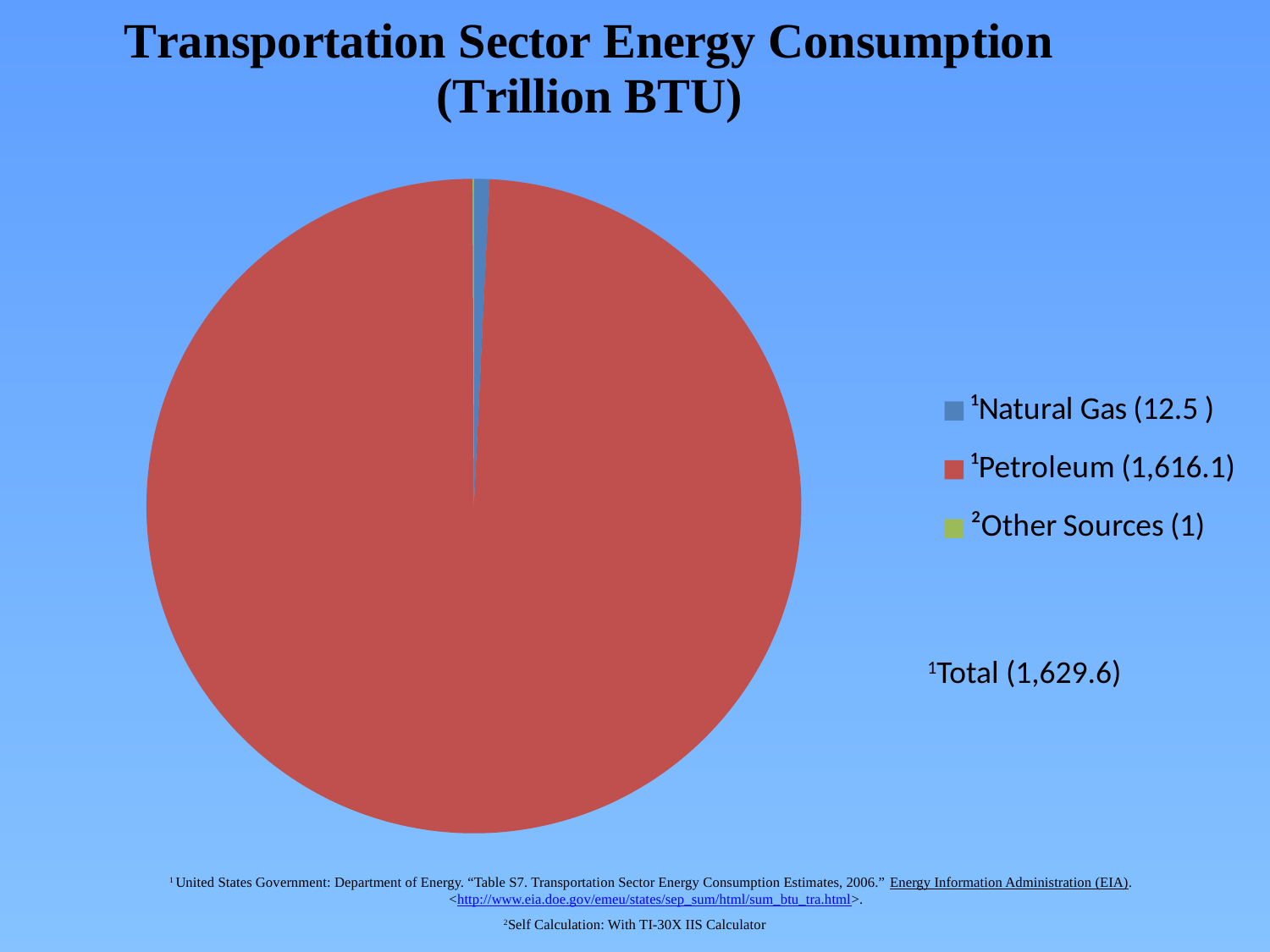
What is the value for Other Sources in the pie chart? 1 Which category has the largest slice of the pie chart? Petroleum How many categories does the pie chart show? 3 What is the difference between the Natural Gas value and the Other Sources value? 11.5 Which is larger, the value for Natural Gas or the value for Other Sources? Natural Gas What type of chart is shown on the slide? pie chart What is the total energy consumption shown on the slide? 1,629.6 What is the value for Petroleum in the pie chart? 1,616.1 Which category has the smallest slice of the pie chart? Other Sources What is the difference between the Petroleum value and the Natural Gas value? 1,603.6 What is the value for Natural Gas in the pie chart? 12.5 What is the title of the chart? Transportation Sector Energy Consumption (Trillion BTU)